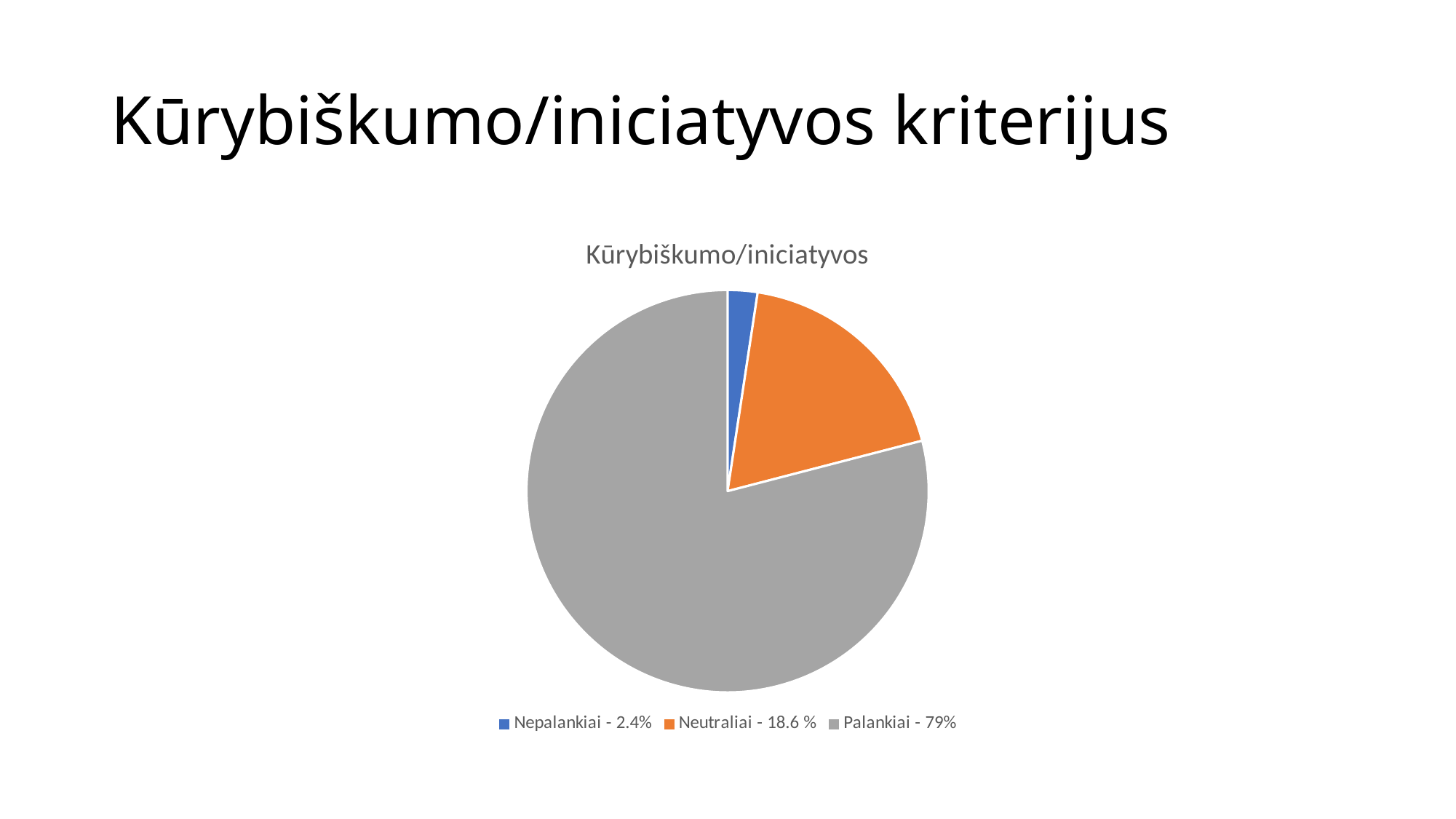
What colour is the Neutraliai slice? orange What share of the pie is labelled Neutraliai? 18.6 % Which category has the smallest slice of the pie? Nepalankiai What share of the pie is labelled Palankiai? 79% How many slices does the pie chart have? 3 Which category has the largest slice of the pie? Palankiai What is the difference in percentage points between the Palankiai and Neutraliai shares? 60.4 What is the title of the chart? Kūrybiškumo/iniciatyvos What kind of chart is shown on the slide? pie chart Which is larger, the Neutraliai slice or the Nepalankiai slice? Neutraliai What share of the pie is labelled Nepalankiai? 2.4% How many entries does the legend list? 3